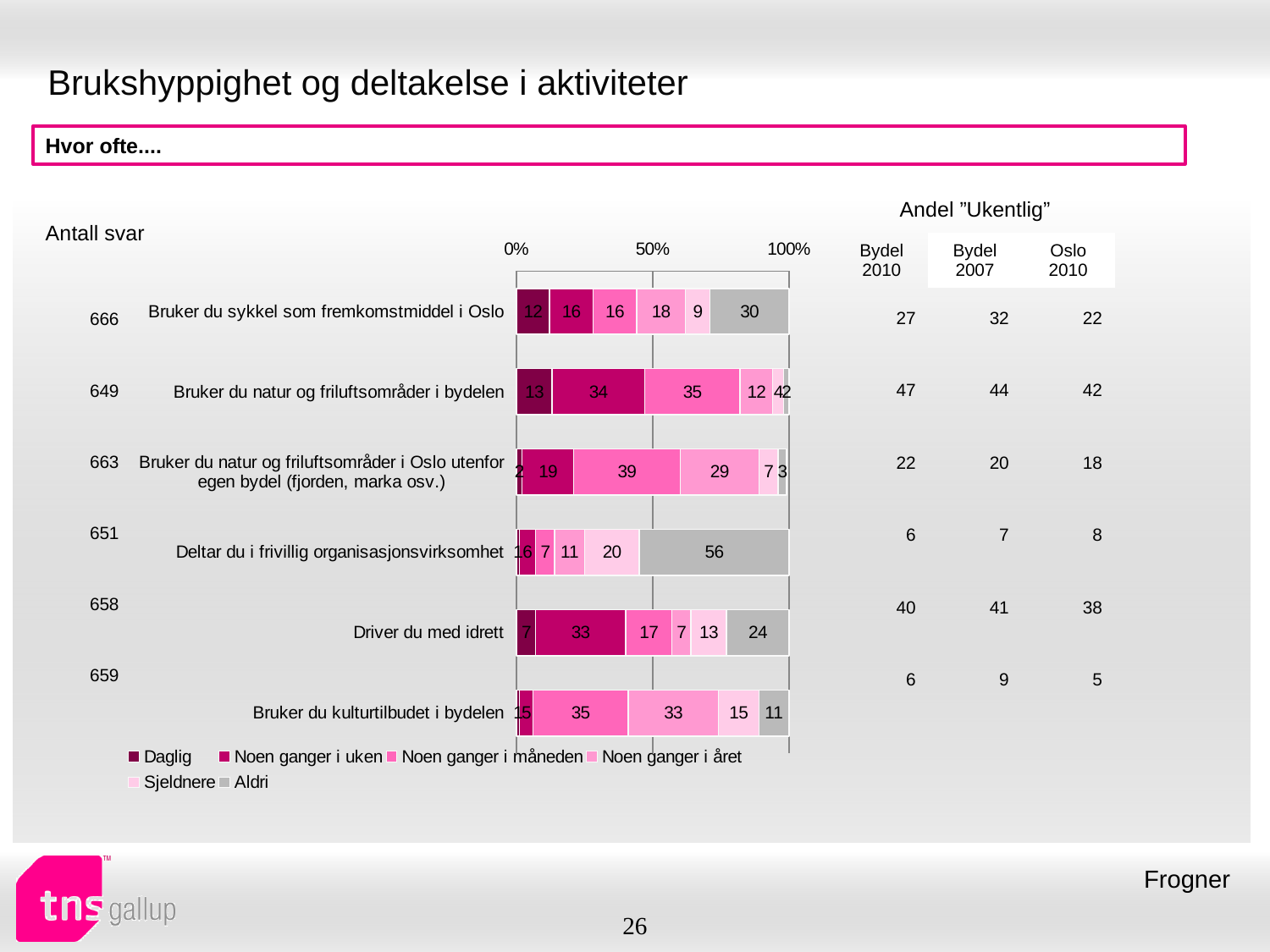
How many series does the chart legend list? 6 What is the 'Noen ganger i uken' value for 'Bruker du natur og friluftsområder i bydelen'? 34 What kind of chart is shown on the slide? bar chart What is the 'Sjeldnere' value for 'Driver du med idrett'? 13 What is the first entry in the chart legend? Daglig What is the difference between the 'Aldri' values for 'Bruker du sykkel som fremkomstmiddel i Oslo' and 'Driver du med idrett'? 6 What is the 'Aldri' value for 'Deltar du i frivillig organisasjonsvirksomhet'? 56 Which category has the highest 'Aldri' value? Deltar du i frivillig organisasjonsvirksomhet What is the 'Aldri' value for 'Bruker du sykkel som fremkomstmiddel i Oslo'? 30 How many categories (questions) are plotted in the chart? 6 Which has the larger 'Noen ganger i uken' value: 'Driver du med idrett' or 'Bruker du sykkel som fremkomstmiddel i Oslo'? Driver du med idrett What is the 'Noen ganger i måneden' value for 'Bruker du natur og friluftsområder i Oslo utenfor egen bydel (fjorden, marka osv.)'? 39